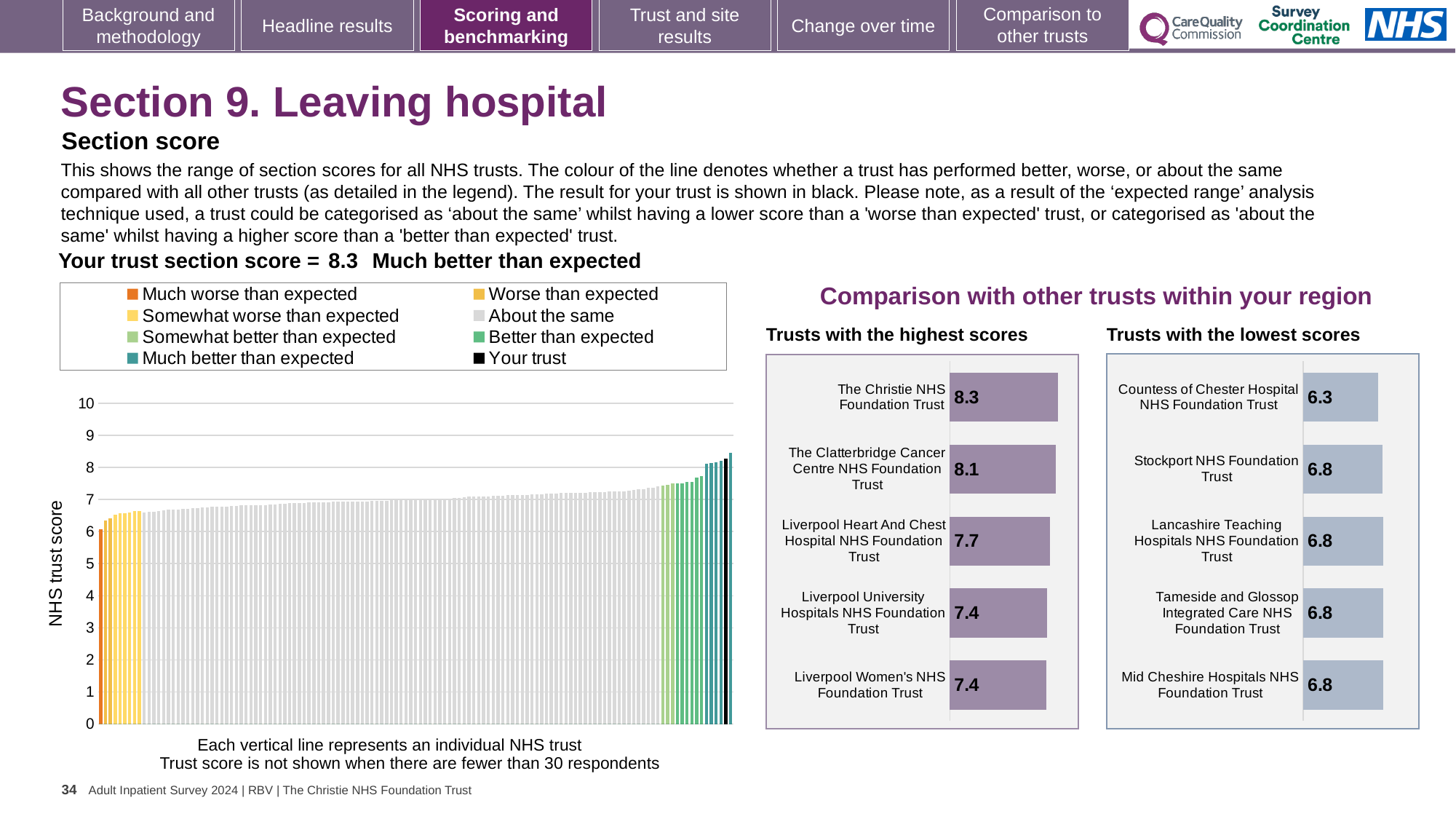
What kind of chart is the large 'NHS trust score' chart on the left of the slide? Bar chart In the 'Trusts with the highest scores' chart, which has the higher score: The Clatterbridge Cancer Centre NHS Foundation Trust or Liverpool Heart And Chest Hospital NHS Foundation Trust? The Clatterbridge Cancer Centre NHS Foundation Trust How many entries does the legend above the large 'NHS trust score' chart list? 8 How many trusts are shown in the 'Trusts with the highest scores' chart? 5 In the large 'NHS trust score' chart on the left, do the values rise or fall from left to right? Rise In the large 'NHS trust score' chart on the left, is the value of the leftmost (orange) bar greater or less than 7? less In the 'Trusts with the highest scores' chart, what is the score for Liverpool Heart And Chest Hospital NHS Foundation Trust? 7.7 In the 'Trusts with the highest scores' chart, what is the score for The Christie NHS Foundation Trust? 8.3 In the 'Trusts with the lowest scores' chart, what is the score for Countess of Chester Hospital NHS Foundation Trust? 6.3 What is the title of the section containing the two small bar charts on the right of the slide? Comparison with other trusts within your region In the 'Trusts with the highest scores' chart, what is the difference between the scores of The Christie NHS Foundation Trust and The Clatterbridge Cancer Centre NHS Foundation Trust? 0.2 In the 'Trusts with the lowest scores' chart, which trust has the lowest score? Countess of Chester Hospital NHS Foundation Trust